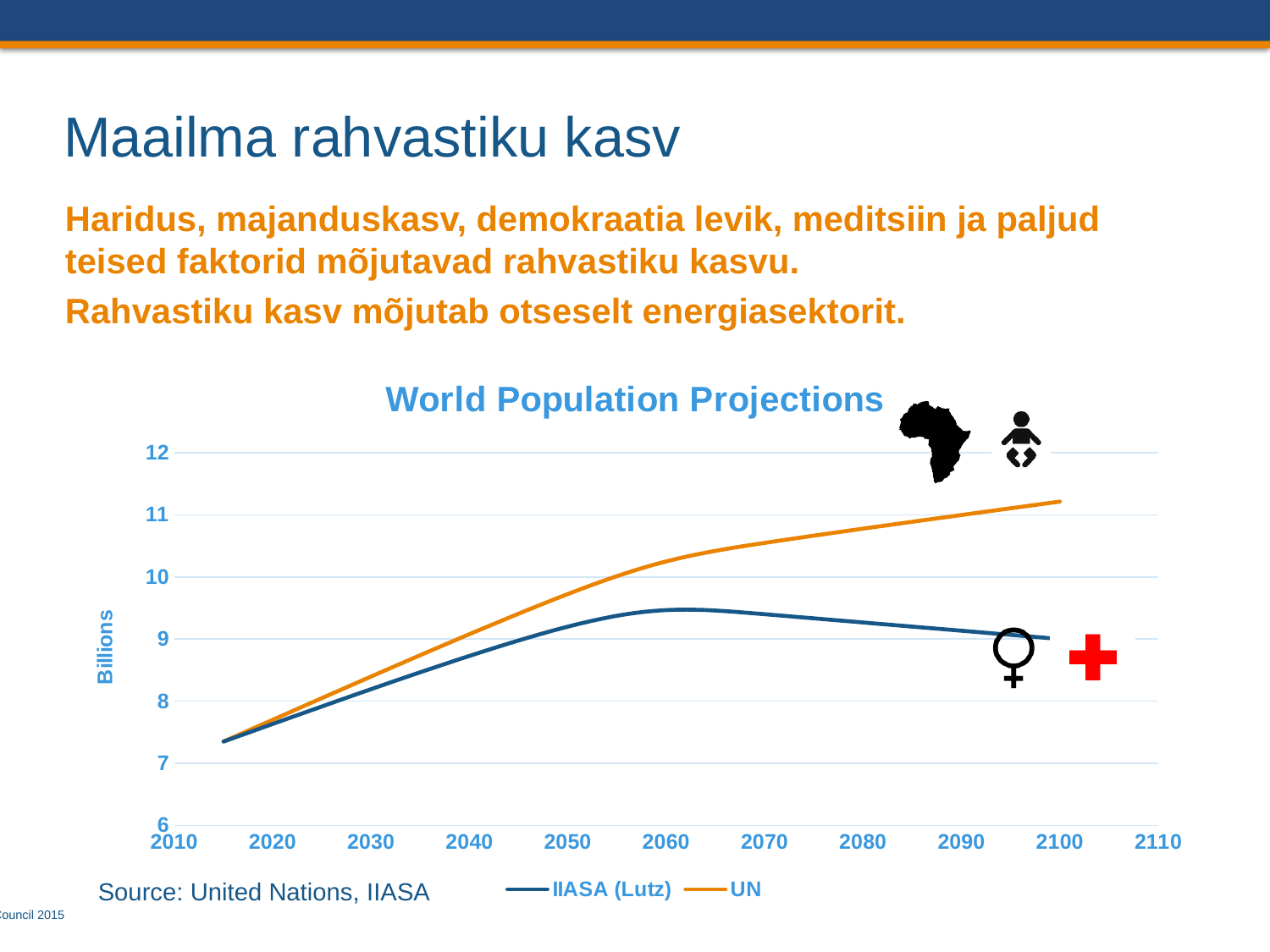
What kind of chart is shown on the slide? line chart After peaking around 2060, does the IIASA (Lutz) projection rise or fall toward 2100? falls Which series reaches the highest value on the chart? UN Which series is higher in 2100, IIASA (Lutz) or UN? UN What are the two series named in the legend of the chart? IIASA (Lutz) and UN What is the label on the vertical axis of the chart? Billions How many series does the legend of the World Population Projections chart list? 2 Does the UN projection rise or fall across the whole period shown? rises Is the IIASA (Lutz) projection for 2060 greater or less than 10 billion? less Is the UN projection for 2070 greater or less than 10 billion? greater Is the UN projection for 2100 greater or less than 11 billion? greater